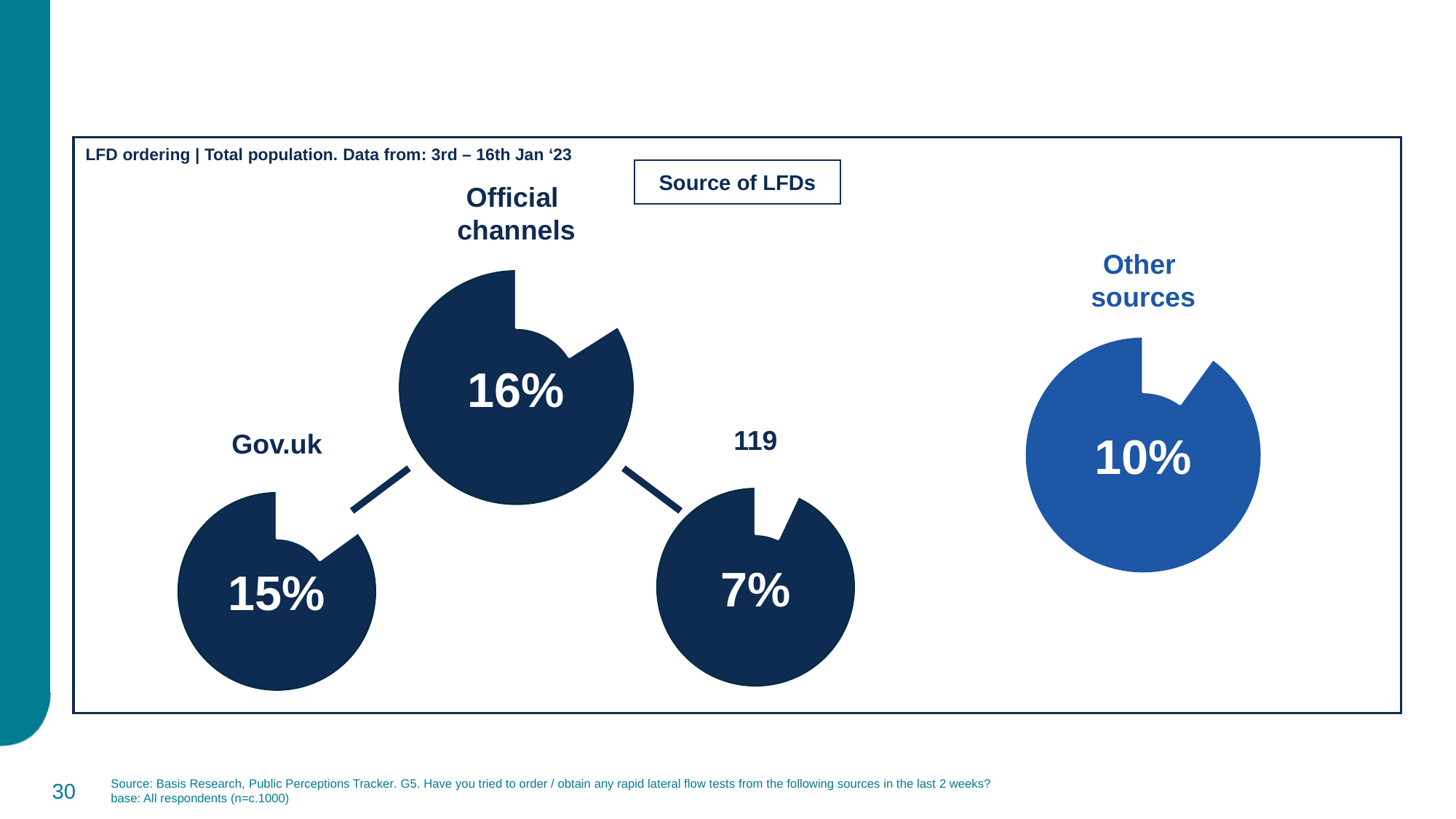
How many separate pie charts are shown on the slide? 4 Which source's chart is drawn in a lighter blue than the others? Other sources Which source has the highest percentage shown? Official channels What is the difference between the Official channels percentage and the Other sources percentage? 6% Which source has the lowest percentage shown? 119 What percentage is shown for Gov.uk? 15% What percentage is shown for Official channels? 16% What is the difference between the Gov.uk percentage and the 119 percentage? 8% What percentage is shown for Other sources? 10% What percentage is shown for 119? 7% Which is larger, the percentage for Other sources or the percentage for 119? Other sources What kind of chart is used to show each source's percentage? Doughnut chart